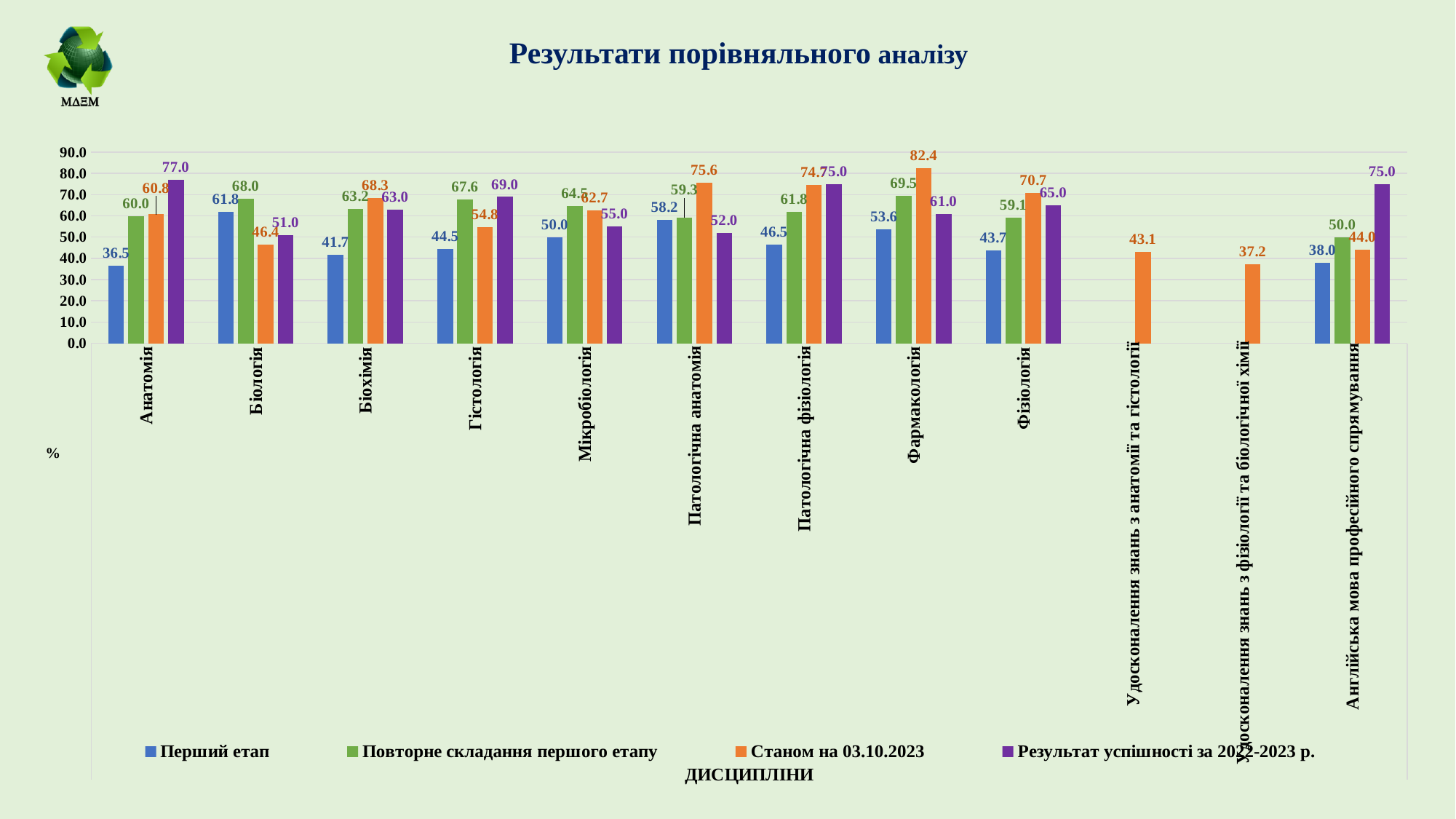
What type of chart is shown on the slide? Bar chart What is the value of the "Станом на 03.10.2023" series for Фармакологія? 82.4 Which discipline has the highest value in the "Станом на 03.10.2023" series? Фармакологія How many disciplines are shown on the x axis? 12 What is the value of the "Перший етап" series for Анатомія? 36.5 For Біологія, which is larger: the "Перший етап" value or the "Станом на 03.10.2023" value? Перший етап What is the value of the "Результат успішності за 2022-2023 р." series for Англійська мова професійного спрямування? 75.0 Which discipline has the highest value in the "Перший етап" series? Біологія How many series does the legend list? 4 Which discipline has the lowest value in the "Перший етап" series? Анатомія Is the "Станом на 03.10.2023" value for Фармакологія greater or less than 80.0? greater For Анатомія, what is the difference between the "Результат успішності за 2022-2023 р." value and the "Перший етап" value? 40.5